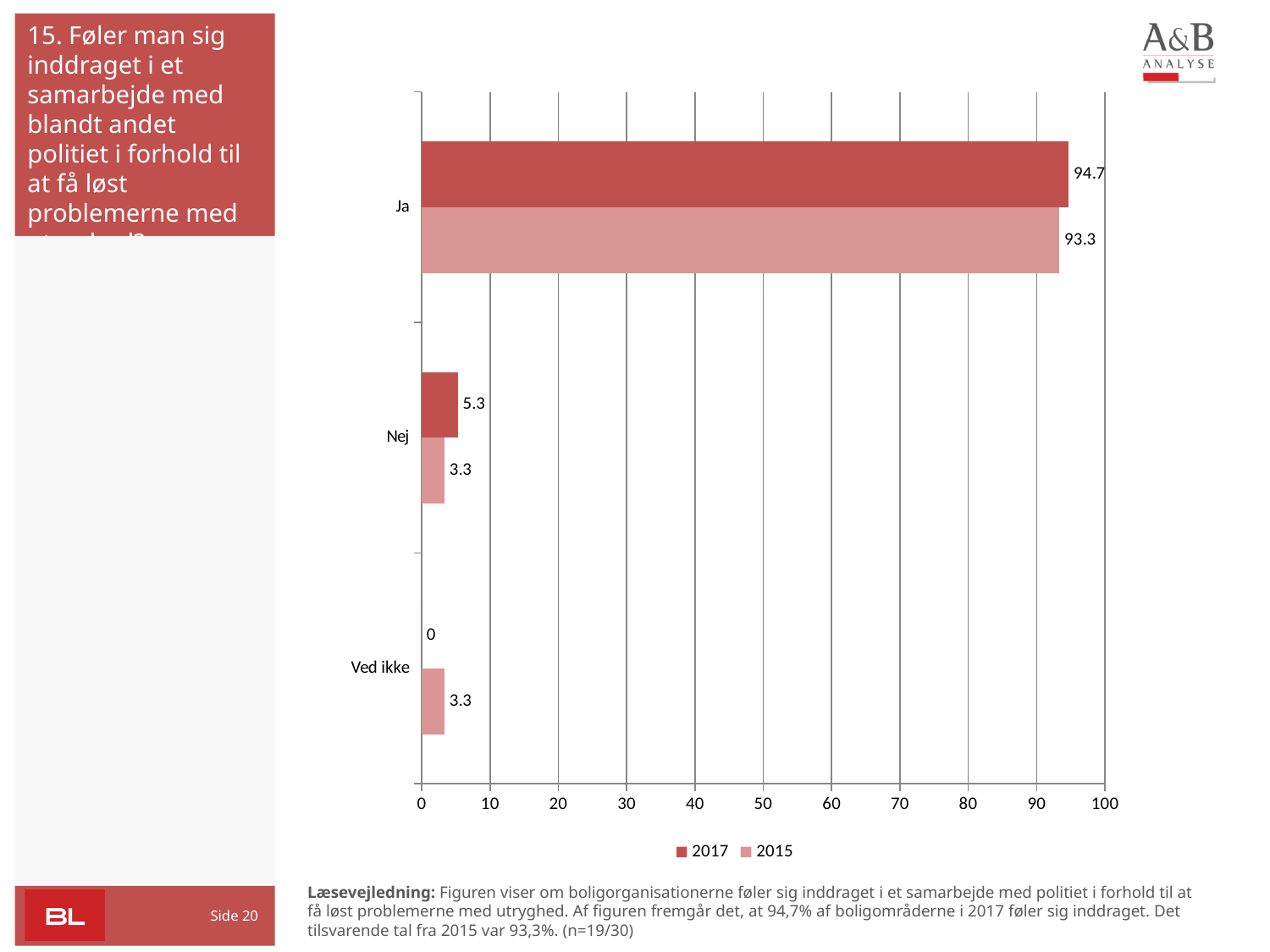
What is the value for "Ja" in the 2017 series? 94.7 What is the value for "Ved ikke" in the 2015 series? 3.3 What is the value for "Ja" in the 2015 series? 93.3 What is the value for "Ved ikke" in the 2017 series? 0 What kind of chart is shown on the slide? Bar chart How many series does the legend list? 2 What is the value for "Nej" in the 2017 series? 5.3 Which category has the lowest value in the 2017 series? Ved ikke Which category has the highest value in the 2017 series? Ja How many categories are shown on the chart? 3 What is the difference between the 2017 and 2015 values for "Ja"? 1.4 Which is larger for "Nej": the 2017 value or the 2015 value? 2017